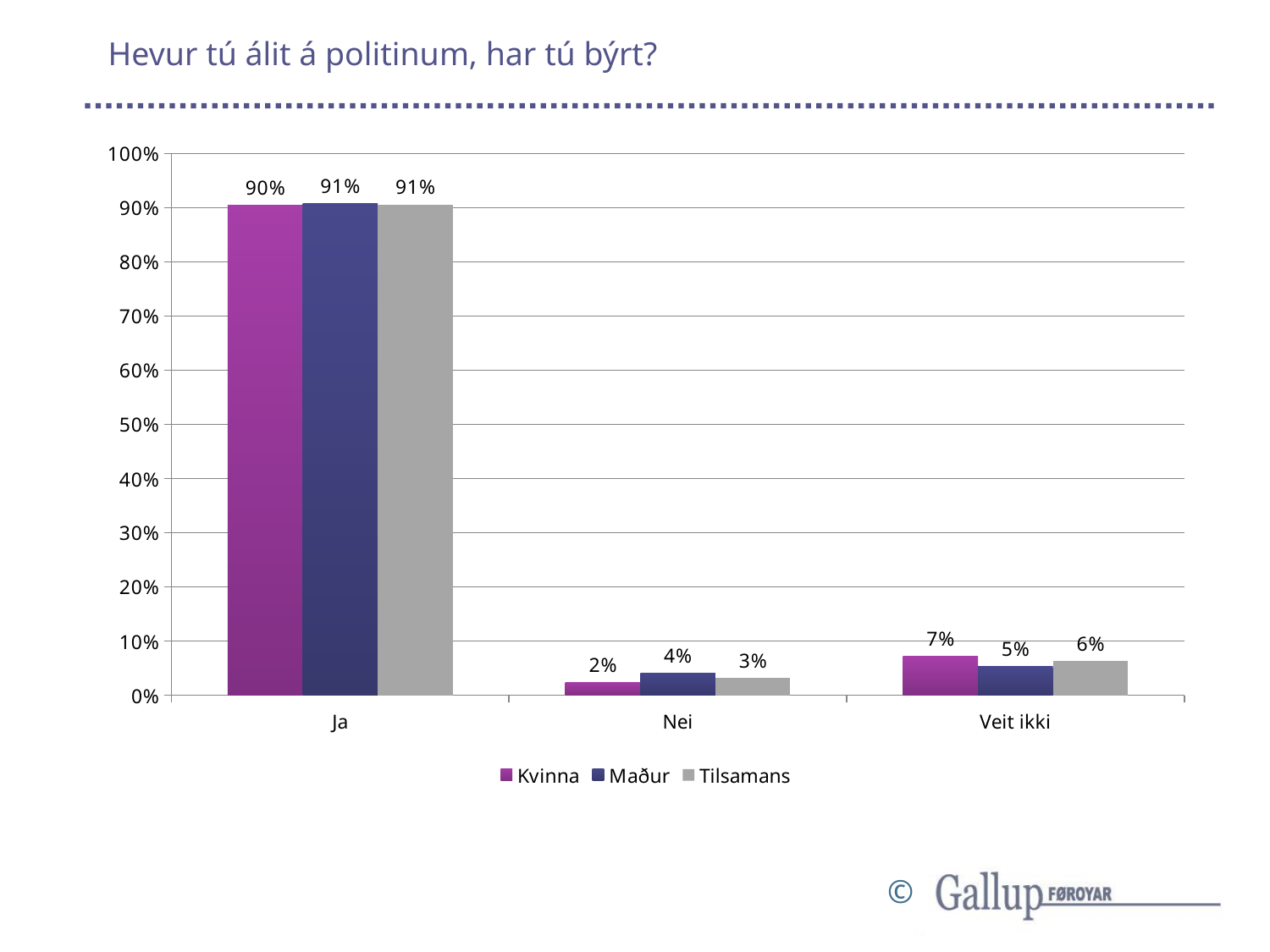
What is the title of the slide? Hevur tú álit á politinum, har tú býrt? Which is larger in the Nei category, the value for Kvinna or the value for Maður? Maður What kind of chart is shown on the slide? Bar chart What is the value for Maður in the Nei category? 4% How many series does the legend list? 3 How many categories are shown on the x axis? 3 Which category has the highest value for Tilsamans? Ja What is the value for Kvinna in the Ja category? 90% What is the value for Tilsamans in the Veit ikki category? 6% What is the difference between the Kvinna and Maður values in the Veit ikki category? 2% Which category has the lowest value for Kvinna? Nei Is the value for Maður in the Ja category greater or less than 80%? greater